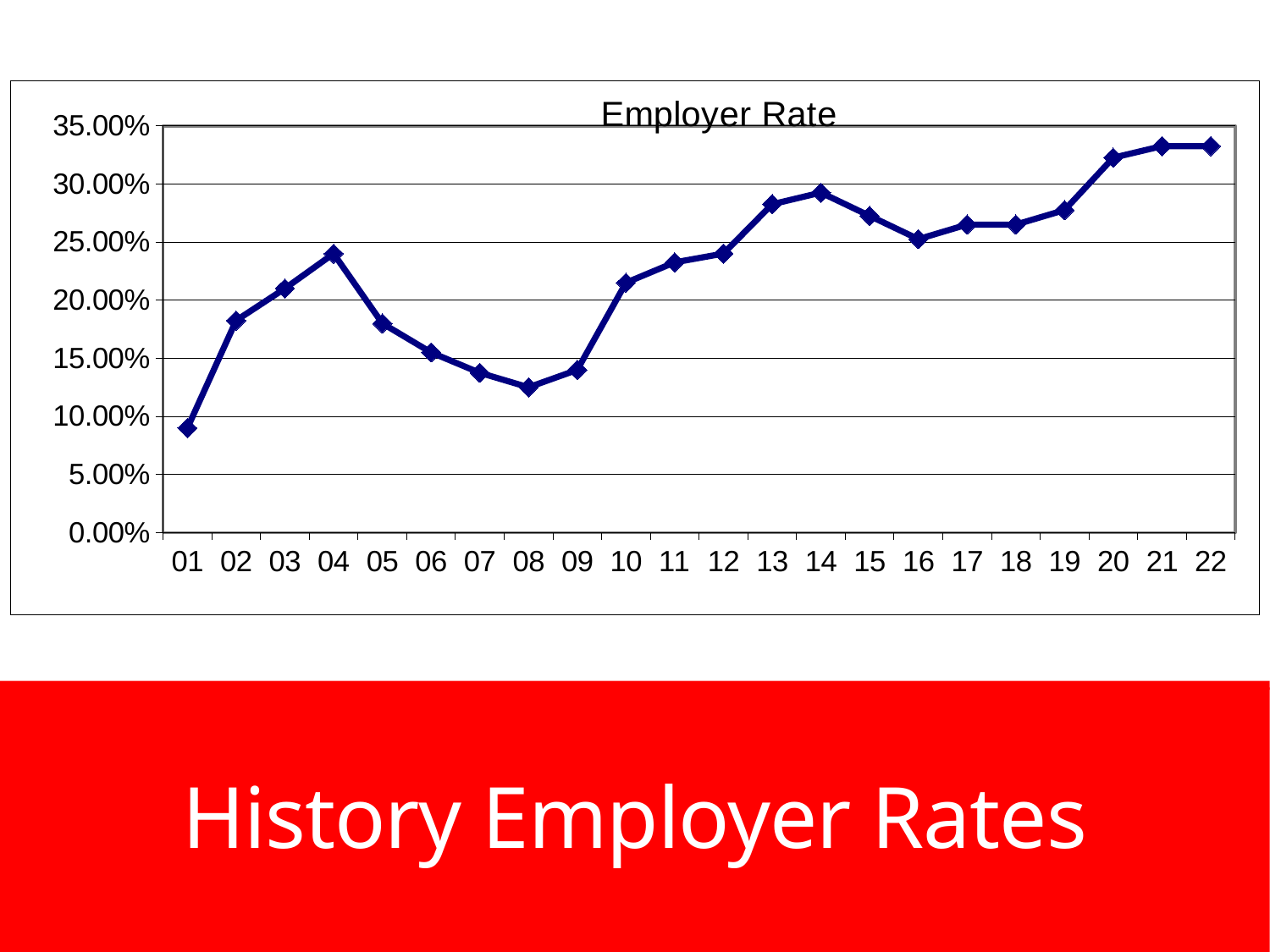
Is the value for 01 greater or less than 10.00%? less What kind of chart is shown on the slide? line chart Is the value for 08 greater or less than 15.00%? less Is the value for 14 greater or less than 30.00%? less How many data points are plotted on the chart? 22 Do the values rise or fall from 04 to 08? fall Which is larger, the value for 04 or the value for 05? 04 Which is larger, the value for 14 or the value for 16? 14 Which year has the lowest employer rate? 01 What is the title of the chart? Employer Rate